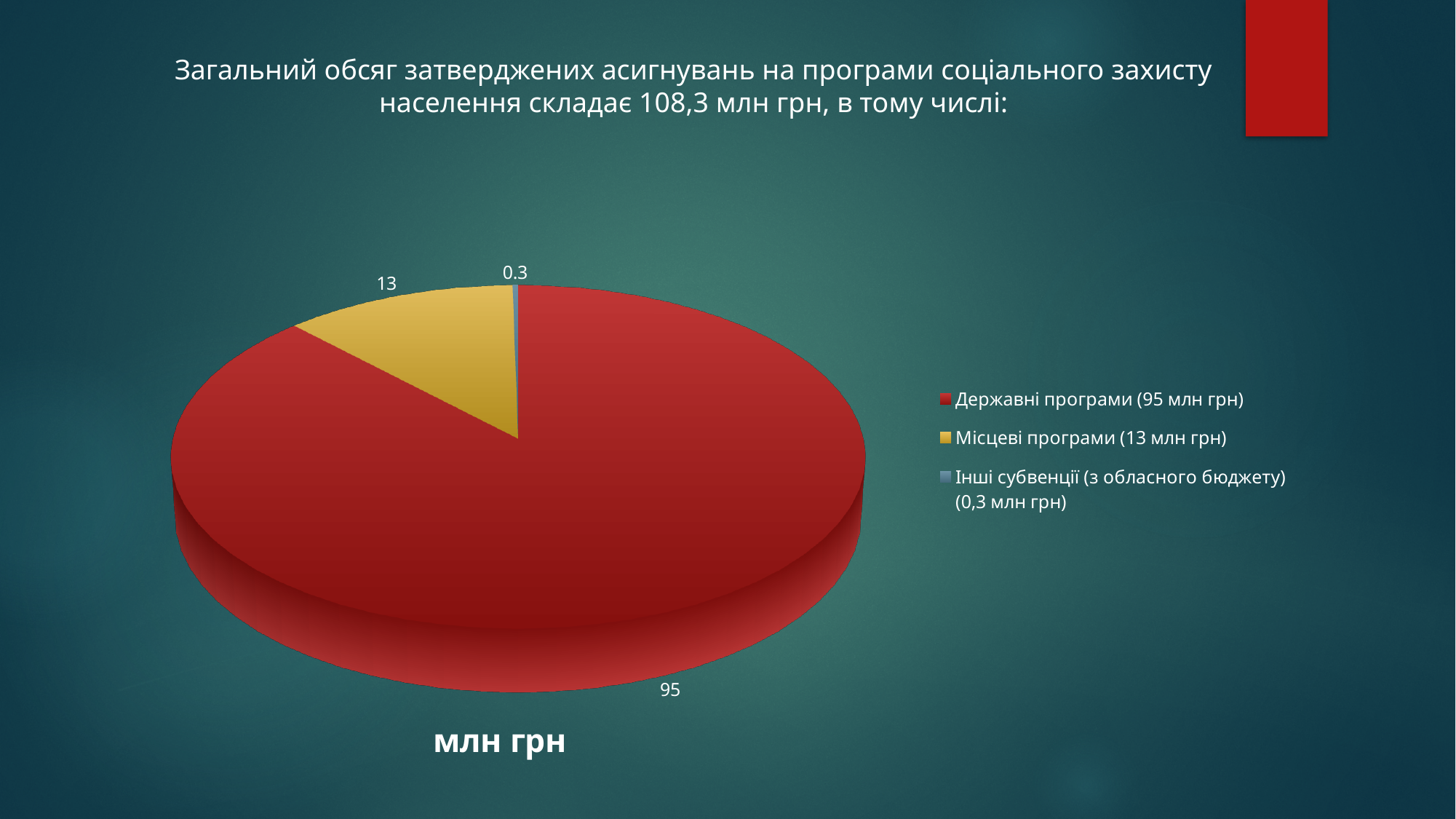
What is the difference between the values for Місцеві програми and Інші субвенції? 12.7 What is the chart's title? млн грн What is the difference between the values for Державні програми and Місцеві програми? 82 Which category has the largest slice of the pie? Державні програми How many slices does the pie chart have? 3 Which category has the smallest slice of the pie? Інші субвенції (з обласного бюджету) Which is larger, the value for Місцеві програми or the value for Інші субвенції? Місцеві програми What is the value for Інші субвенції (з обласного бюджету)? 0.3 What is the value for Місцеві програми? 13 What colour is the slice for Місцеві програми? yellow What type of chart is shown on the slide? pie chart What is the value for Державні програми? 95